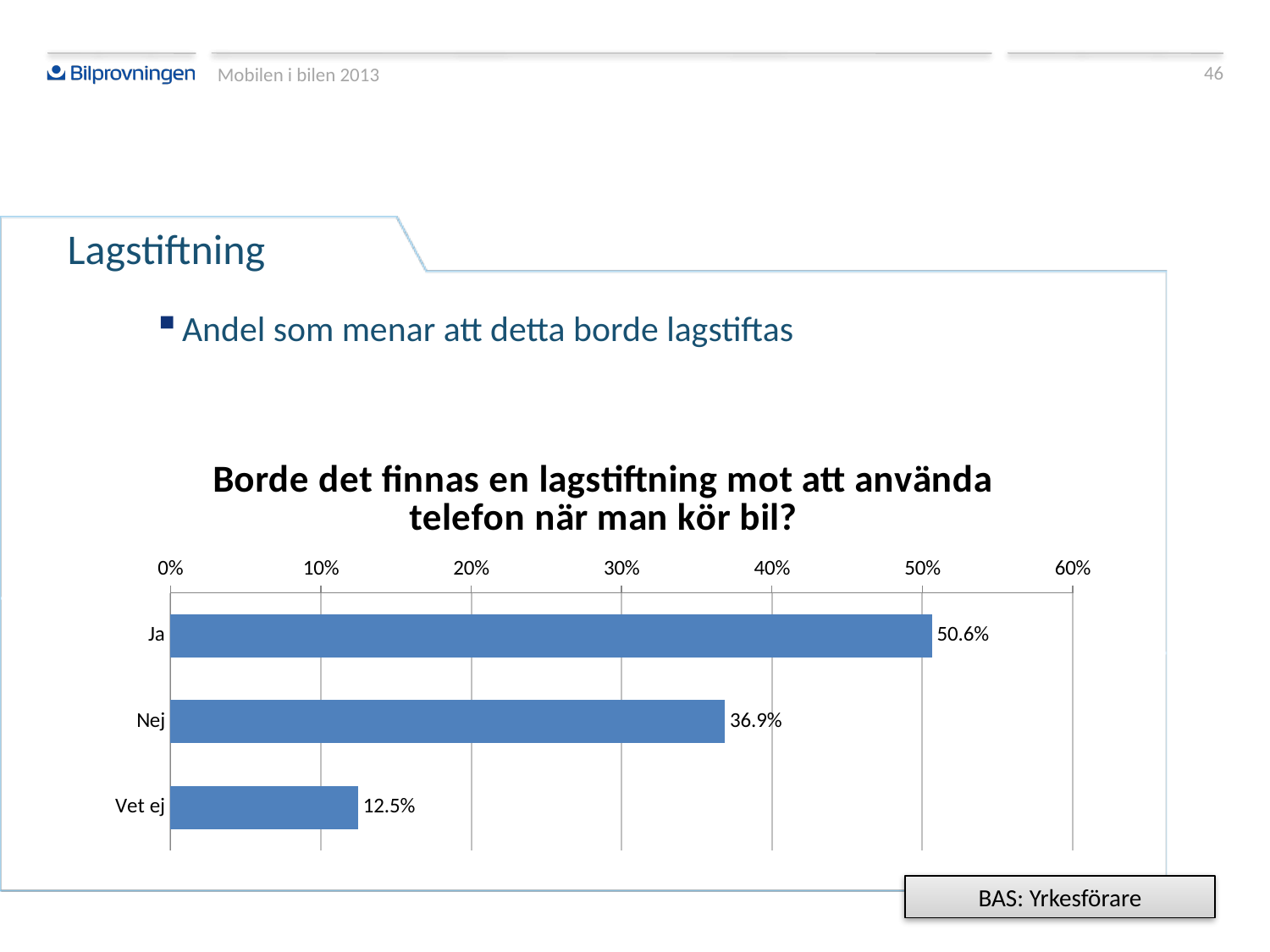
What is the difference between the values for "Ja" and "Nej"? 13.7% What is the title of the chart? Borde det finnas en lagstiftning mot att använda telefon när man kör bil? Is the value for "Ja" greater or less than 50%? greater How many categories are shown in the chart? 3 What is the value for "Ja"? 50.6% Which is larger, the value for "Nej" or the value for "Vet ej"? Nej What is the difference between the values for "Nej" and "Vet ej"? 24.4% What kind of chart is shown on the slide? bar chart Which category has the lowest value? Vet ej What is the value for "Vet ej"? 12.5% Which category has the highest value? Ja What is the value for "Nej"? 36.9%